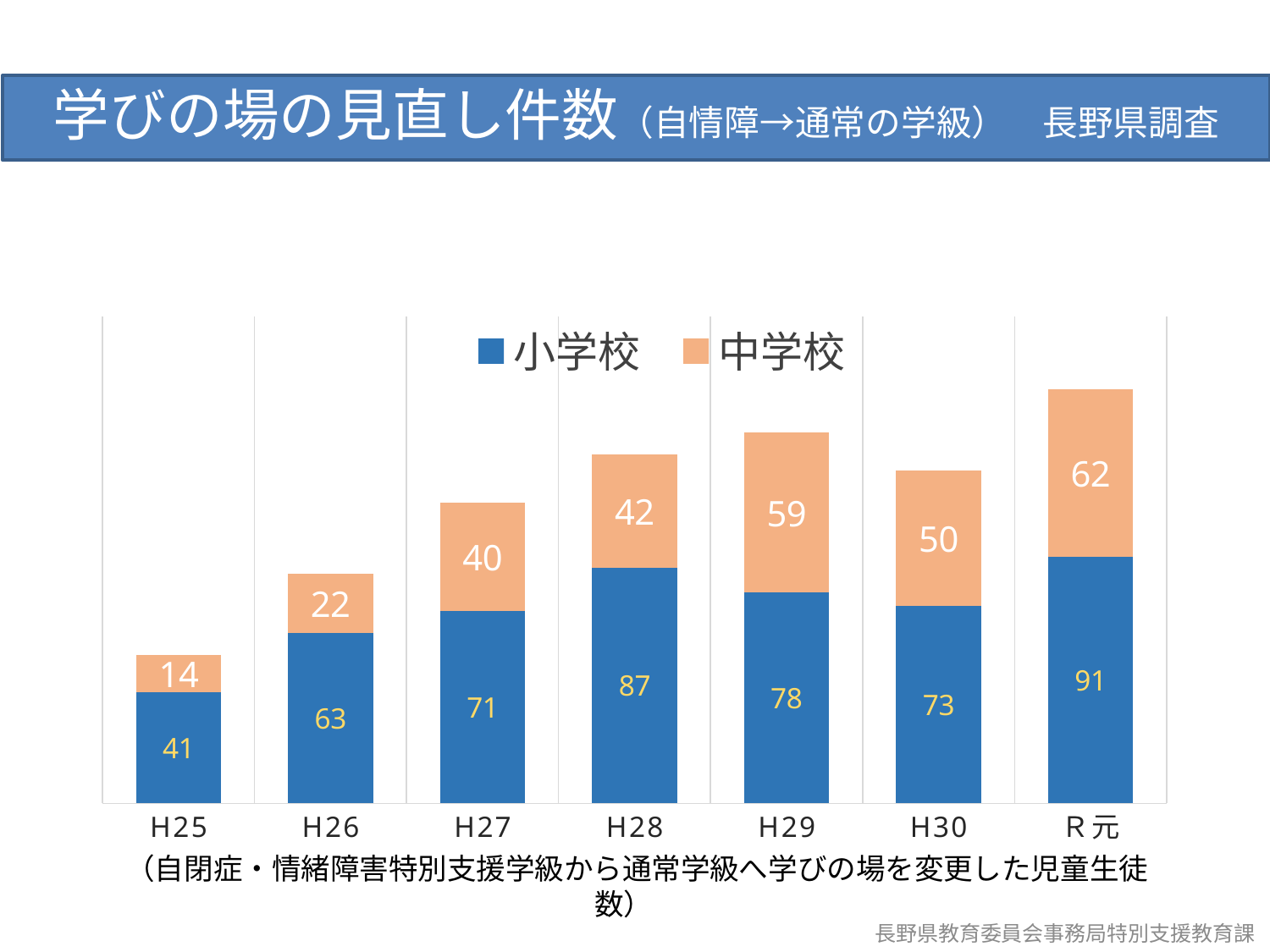
What kind of chart is shown on the slide? Stacked bar chart Which year has the lowest value for 中学校? H25 What is the value for 小学校 in H28? 87 How many series does the legend list? 2 What is the difference between the 中学校 values for H29 and H30? 9 What is the total of the stacked bar for H27? 111 What is the value for 中学校 in H25? 14 Which is larger, the 小学校 value for H29 or for H30? H29 How many years are shown on the x axis? 7 Which year has the highest value for 小学校? R元 What is the value for 中学校 in R元? 62 Which colour represents 中学校 in the legend? Orange